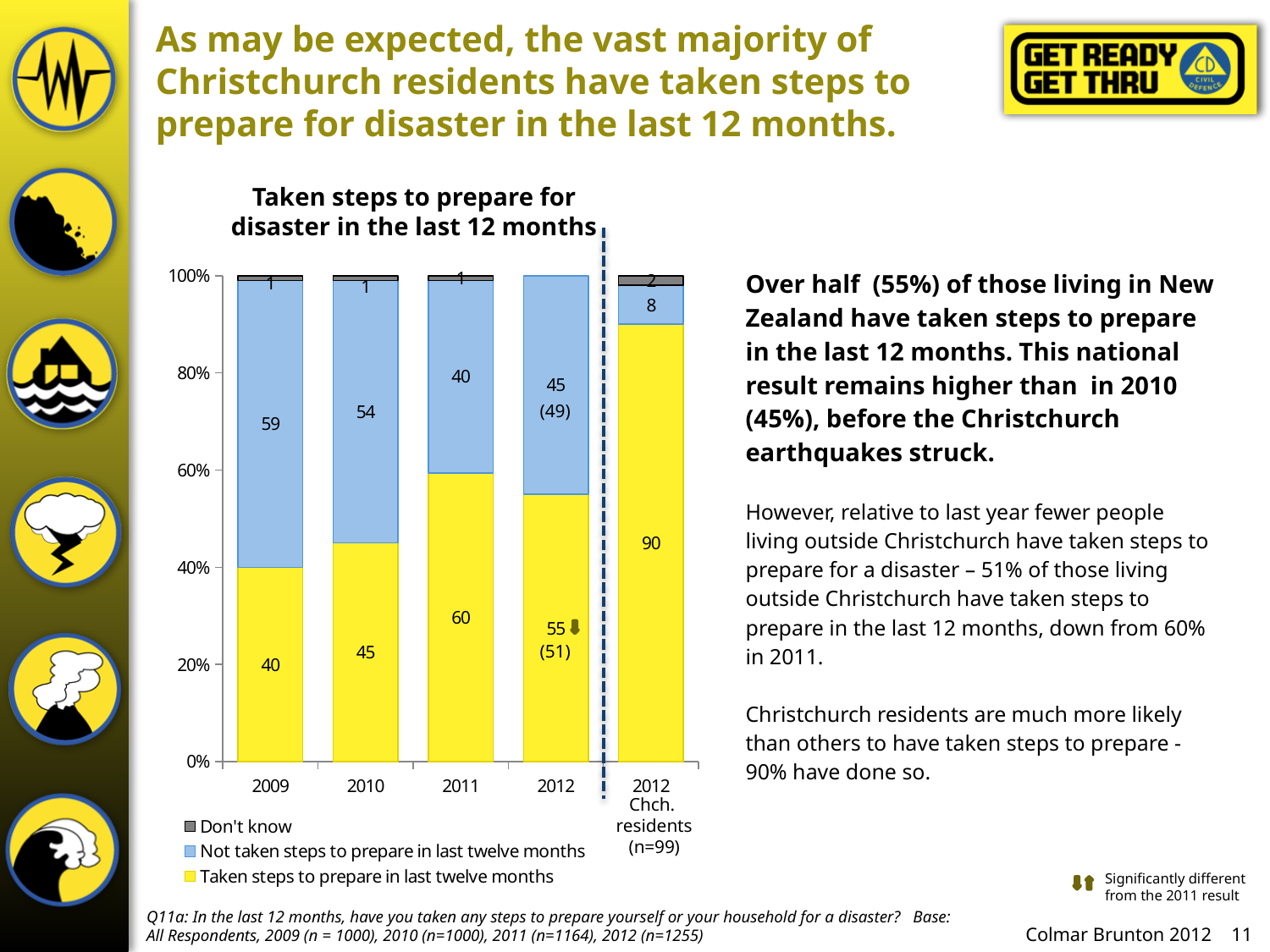
What is the 'Don't know' value for 2012 Chch. residents? 2 Which category has the lowest value for 'Taken steps to prepare in last twelve months'? 2009 How many series does the chart legend list? 3 What is the value for 'Taken steps to prepare in last twelve months' for 2012 Chch. residents? 90 How many categories are shown along the x axis of the chart? 5 What is the difference between the 'Taken steps to prepare in last twelve months' values for 2011 and 2010? 15 What is the value for 'Taken steps to prepare in last twelve months' in 2009? 40 What is the value for 'Not taken steps to prepare in last twelve months' in 2010? 54 Which category has the highest value for 'Taken steps to prepare in last twelve months'? 2012 Chch. residents What is the title of the chart? Taken steps to prepare for disaster in the last 12 months What type of chart is shown on the slide? Stacked bar chart Which is larger: the 'Not taken steps to prepare in last twelve months' value for 2009 or for 2011? 2009